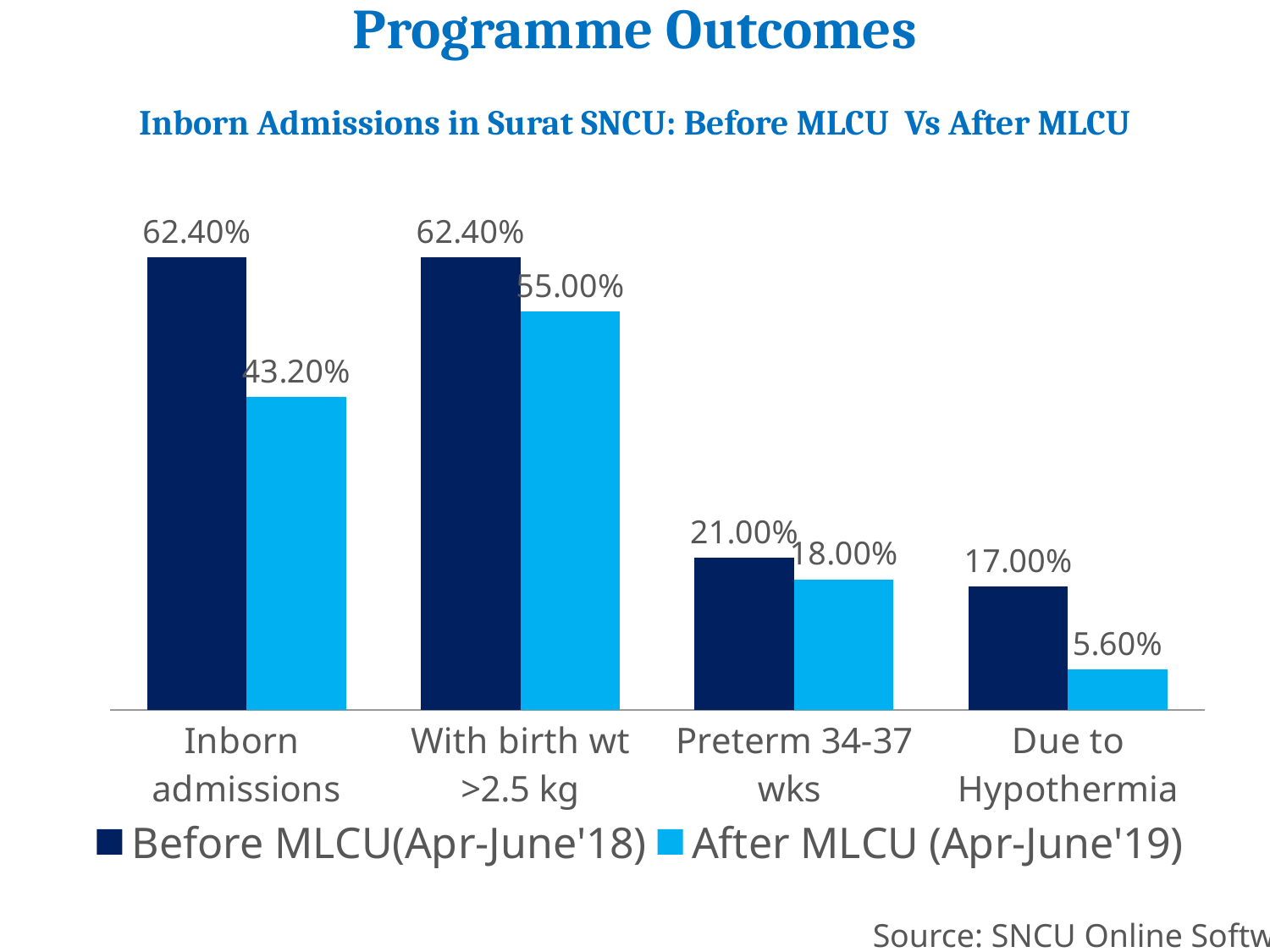
How many categories are shown on the x axis? 4 What kind of chart is shown on the slide? Bar chart What is the difference between the Before MLCU and After MLCU values for Inborn admissions? 19.20 percentage points What is the value for Inborn admissions in the Before MLCU(Apr-June'18) series? 62.40% For Preterm 34-37 wks, which is larger: the Before MLCU value or the After MLCU value? Before MLCU What is the value for With birth wt >2.5 kg in the Before MLCU(Apr-June'18) series? 62.40% What is the difference between the Before MLCU and After MLCU values for Due to Hypothermia? 11.40 percentage points How many series does the legend list? 2 Which category has the highest value in the After MLCU (Apr-June'19) series? With birth wt >2.5 kg What is the value for Due to Hypothermia in the After MLCU (Apr-June'19) series? 5.60% Which category has the lowest value in the Before MLCU(Apr-June'18) series? Due to Hypothermia What is the value for Preterm 34-37 wks in the After MLCU (Apr-June'19) series? 18.00%